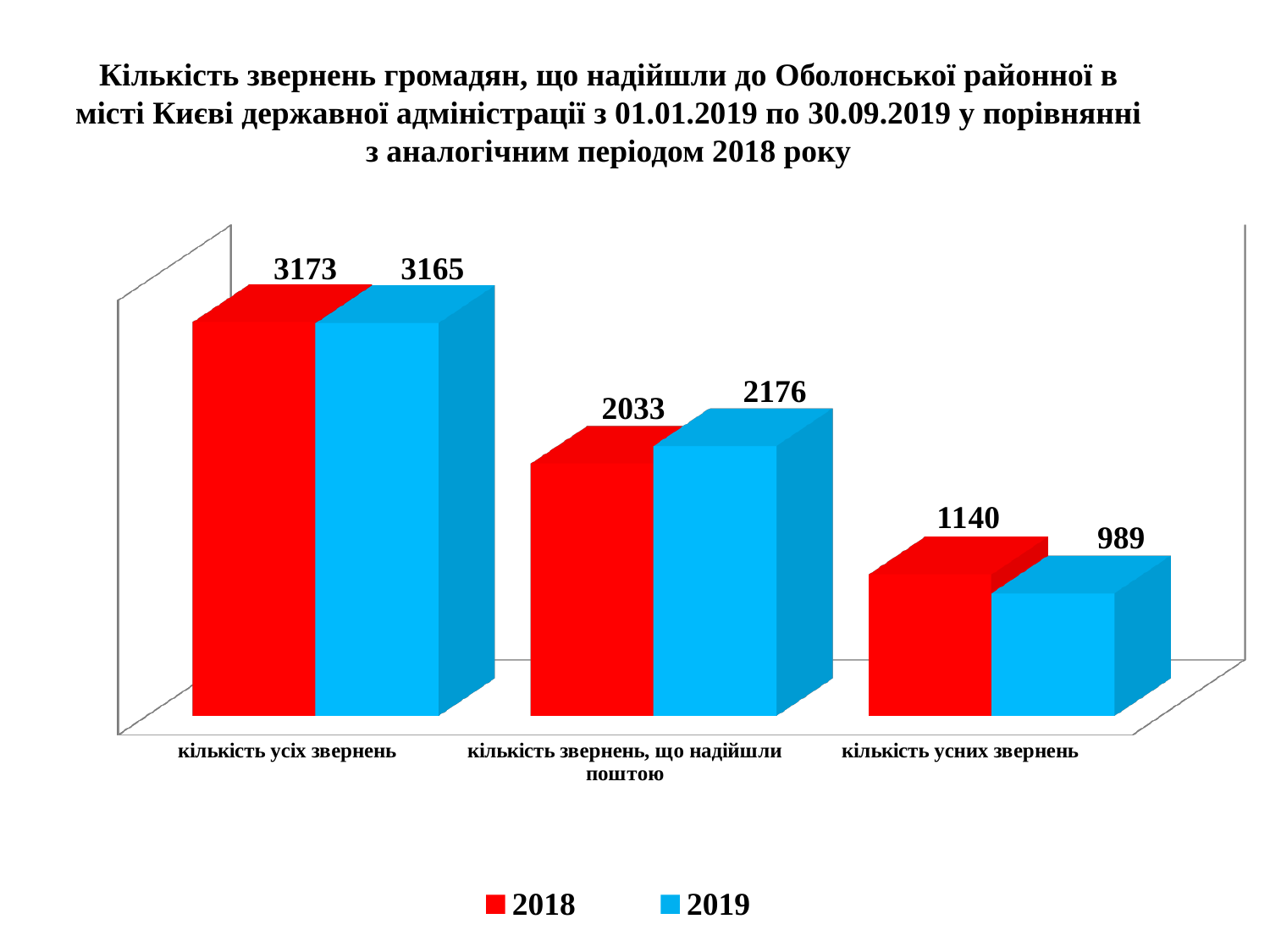
What is the value for 2019 in the category "кількість звернень, що надійшли поштою"? 2176 What is the value for 2018 in the category "кількість усних звернень"? 1140 For "кількість звернень, що надійшли поштою", which series has the larger value, 2018 or 2019? 2019 Which category has the lowest value for the 2018 series? кількість усних звернень What is the difference between the 2019 and 2018 values for "кількість звернень, що надійшли поштою"? 143 What kind of chart is shown on the slide? bar chart What is the difference between the 2018 and 2019 values for "кількість усних звернень"? 151 Which category has the highest value for the 2019 series? кількість усіх звернень What is the value for 2019 in the category "кількість усних звернень"? 989 How many categories are shown on the x axis? 3 How many series does the legend list? 2 What is the value for 2018 in the category "кількість усіх звернень"? 3173